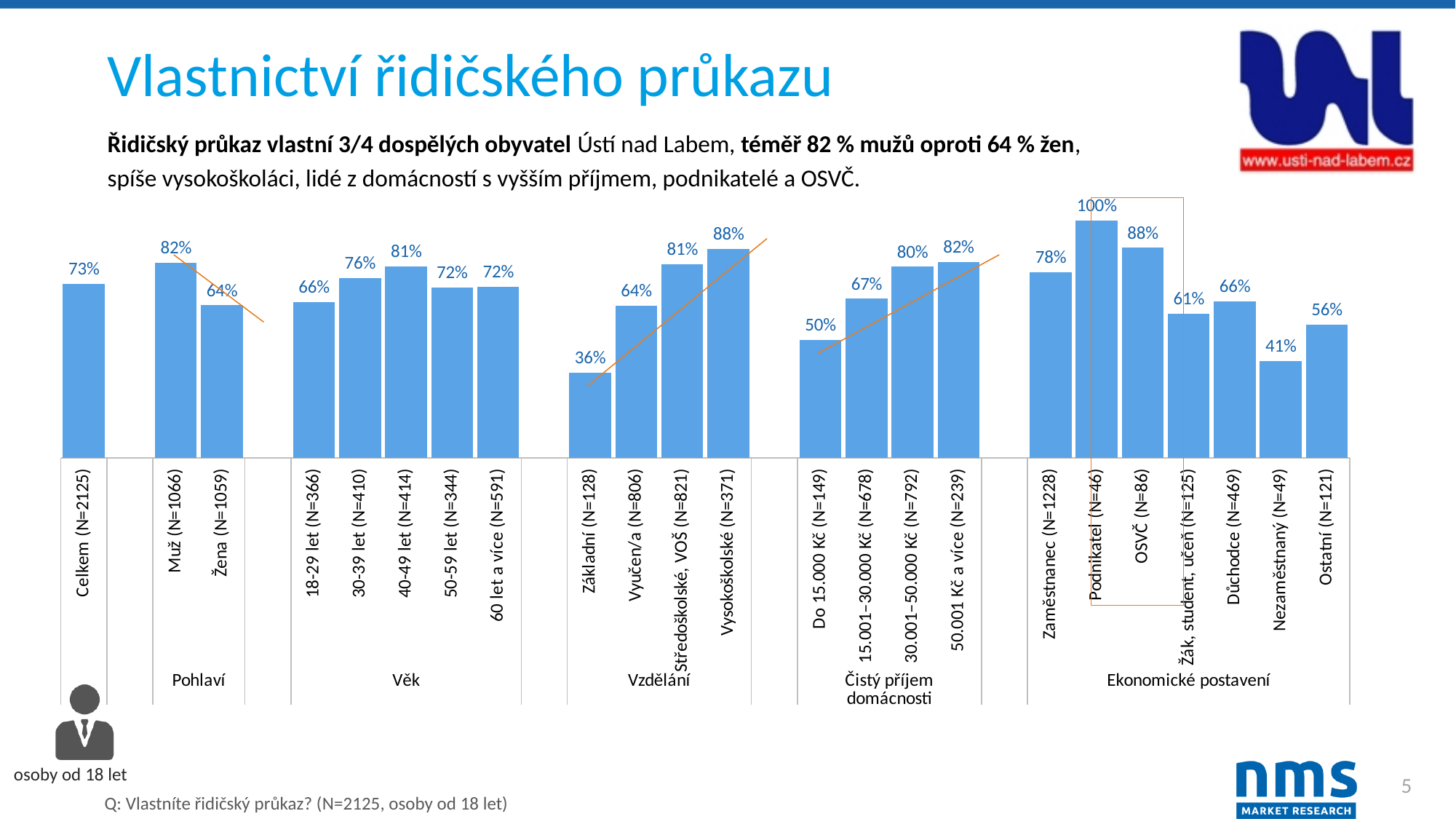
How many categories are in the Ekonomické postavení group? 7 What is the value for Žena (N=1059)? 64% Do the values rise or fall across the Čistý příjem domácnosti categories from Do 15.000 Kč to 50.001 Kč a více? rise Which is larger, the value for Vysokoškolské or the value for Středoškolské, VOŠ? Vysokoškolské What is the value for Celkem (N=2125)? 73% What is the value for Nezaměstnaný (N=49)? 41% Which category has the lowest value on the chart? Základní (N=128) What is the value for Základní (N=128) in the Vzdělání group? 36% What kind of chart is shown on the slide? bar chart Which category has the highest value on the chart? Podnikatel (N=46) What is the difference between the values for Muž and Žena? 18 percentage points How many bars are plotted on the chart in total? 23